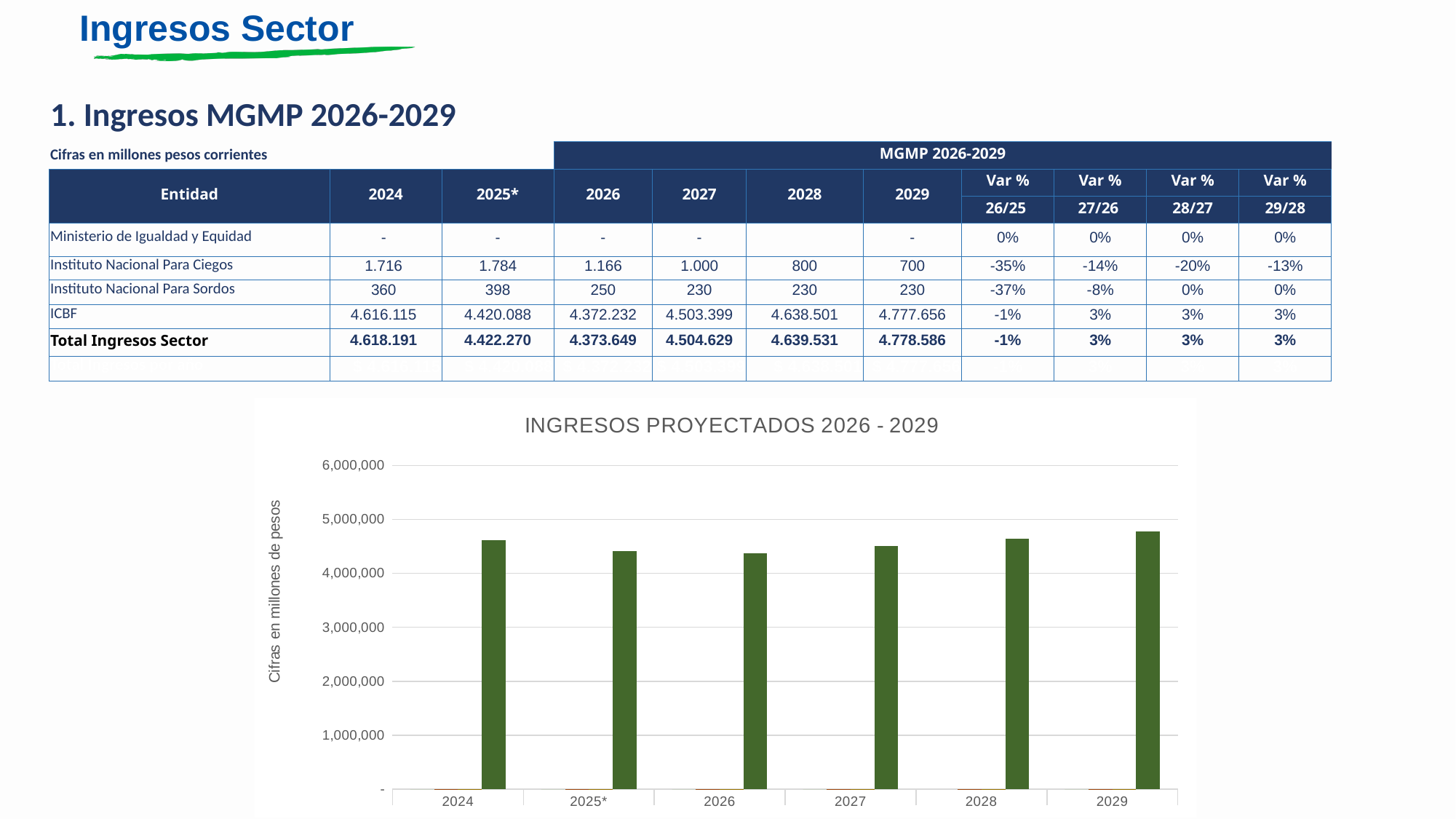
What is the label on the vertical axis of the chart? Cifras en millones de pesos Do the green bars rise or fall from 2026 to 2029? rise Is the green bar for 2024 greater or less than 4,000,000? greater Is the green bar for 2027 greater or less than 3,000,000? greater Which green bar is taller, 2029 or 2026? 2029 Is the green bar for 2026 greater or less than 5,000,000? less How many year categories are shown on the x axis of the chart? 6 What is the title of the chart on the slide? INGRESOS PROYECTADOS 2026 - 2029 Which year has the tallest green bar in the chart? 2029 Which green bar is taller, 2024 or 2026? 2024 What kind of chart is shown on the slide? Bar chart